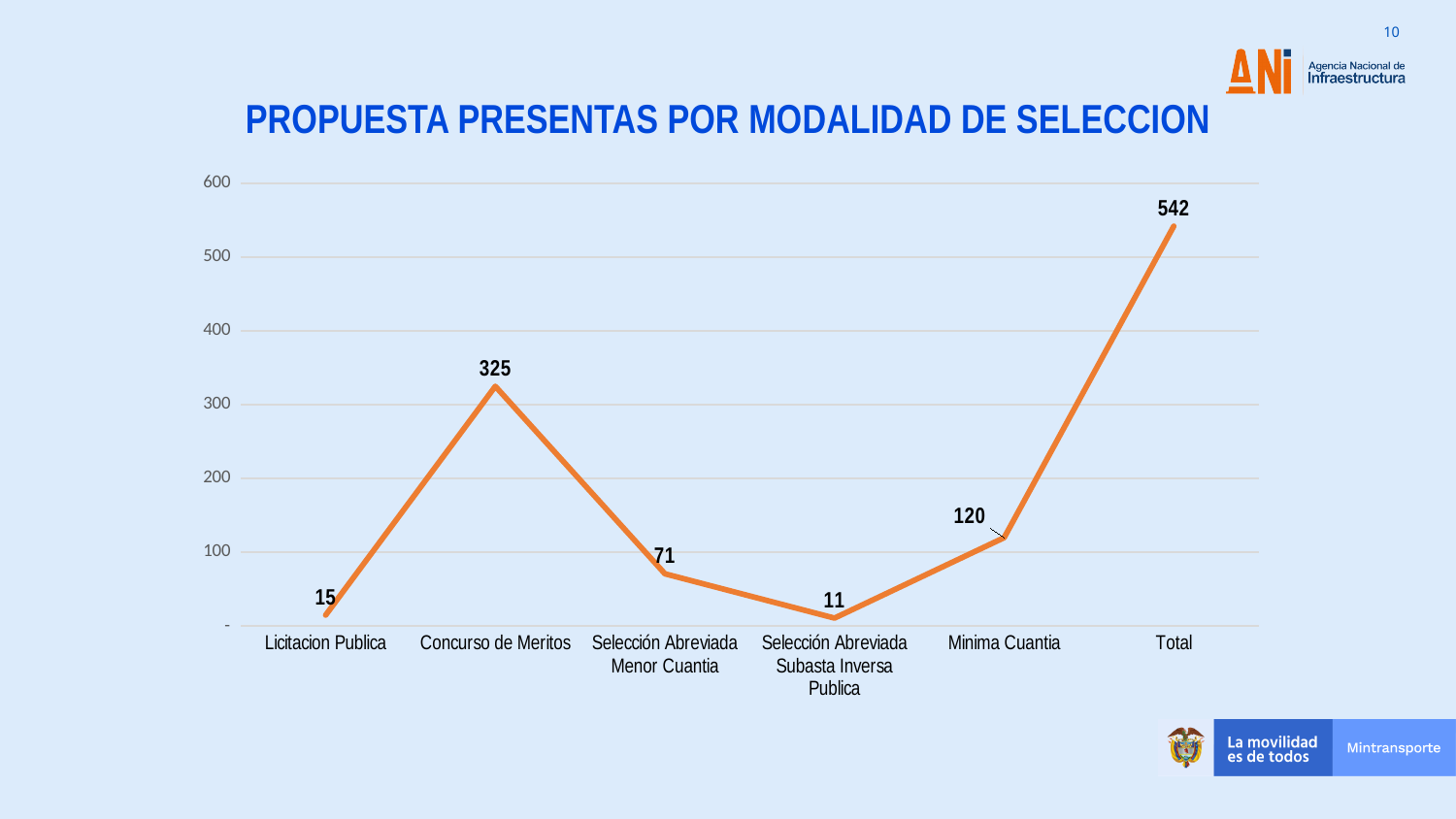
What is the difference between the values for Concurso de Meritos and Minima Cuantia? 205 What value is shown for Concurso de Meritos? 325 How many categories are plotted along the x axis? 6 What is the value of the Total point? 542 What kind of chart is shown on the slide? Line chart Which category has the lowest value? Selección Abreviada Subasta Inversa Publica Is the value for Concurso de Meritos greater or less than 300? greater What value is shown for Selección Abreviada Subasta Inversa Publica? 11 Excluding the Total point, which category has the highest value? Concurso de Meritos What value is shown for Minima Cuantia? 120 Which is larger, the value for Licitacion Publica or the value for Selección Abreviada Menor Cuantia? Selección Abreviada Menor Cuantia What is the title of the chart? PROPUESTA PRESENTAS POR MODALIDAD DE SELECCION